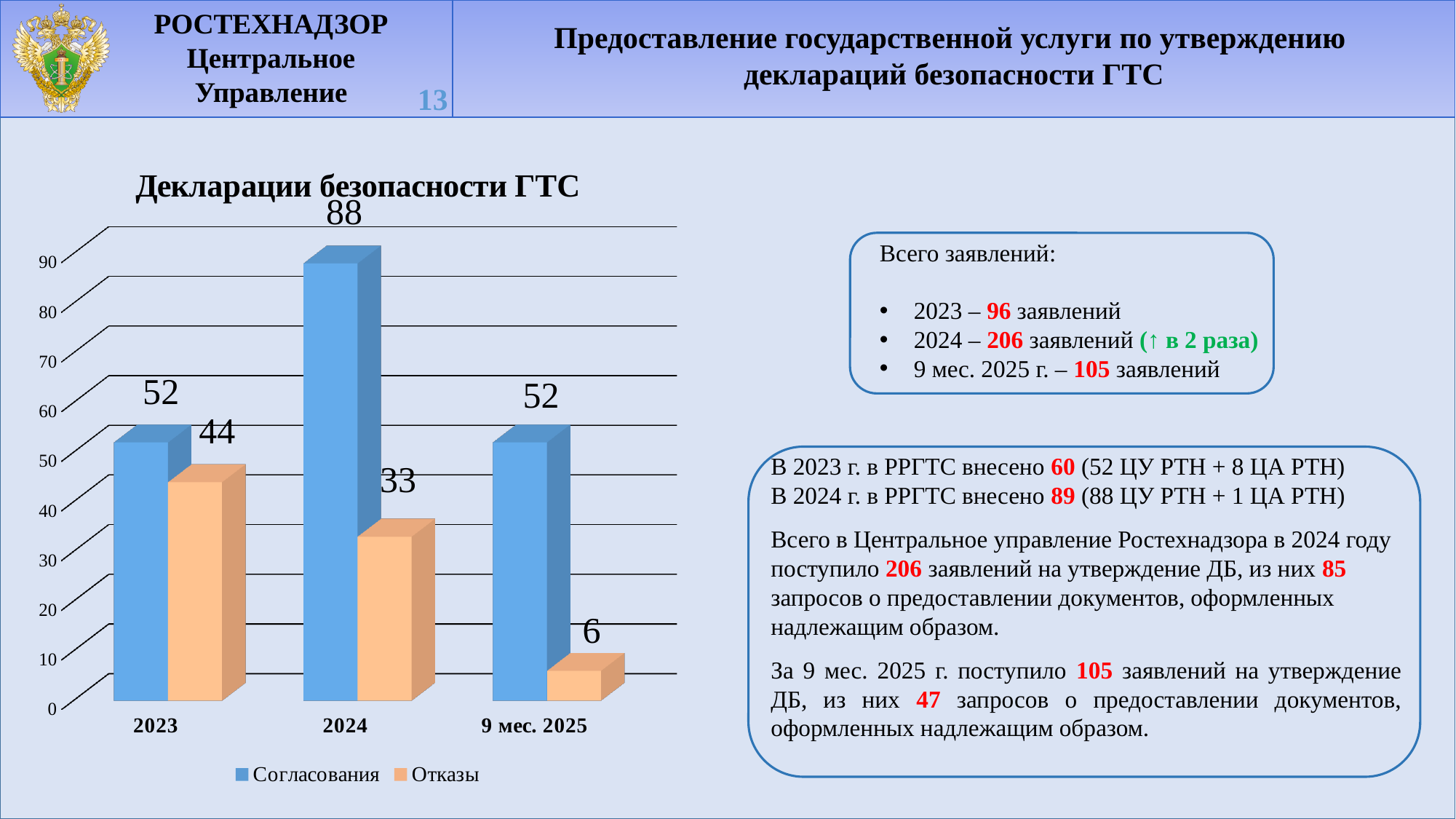
What is the value for Отказы in 2023? 44 How many series does the legend list? 2 What is the difference between Согласования and Отказы in 2024? 55 Which is larger in 2023: Согласования or Отказы? Согласования How many categories are shown on the x axis? 3 Which category has the highest value for Согласования? 2024 What kind of chart is shown? bar chart Is the value for Отказы in 2024 greater or less than 40? less What is the value for Отказы in 9 мес. 2025? 6 What is the value for Согласования in 2024? 88 What is the title of the chart? Декларации безопасности ГТС Which category has the lowest value for Отказы? 9 мес. 2025